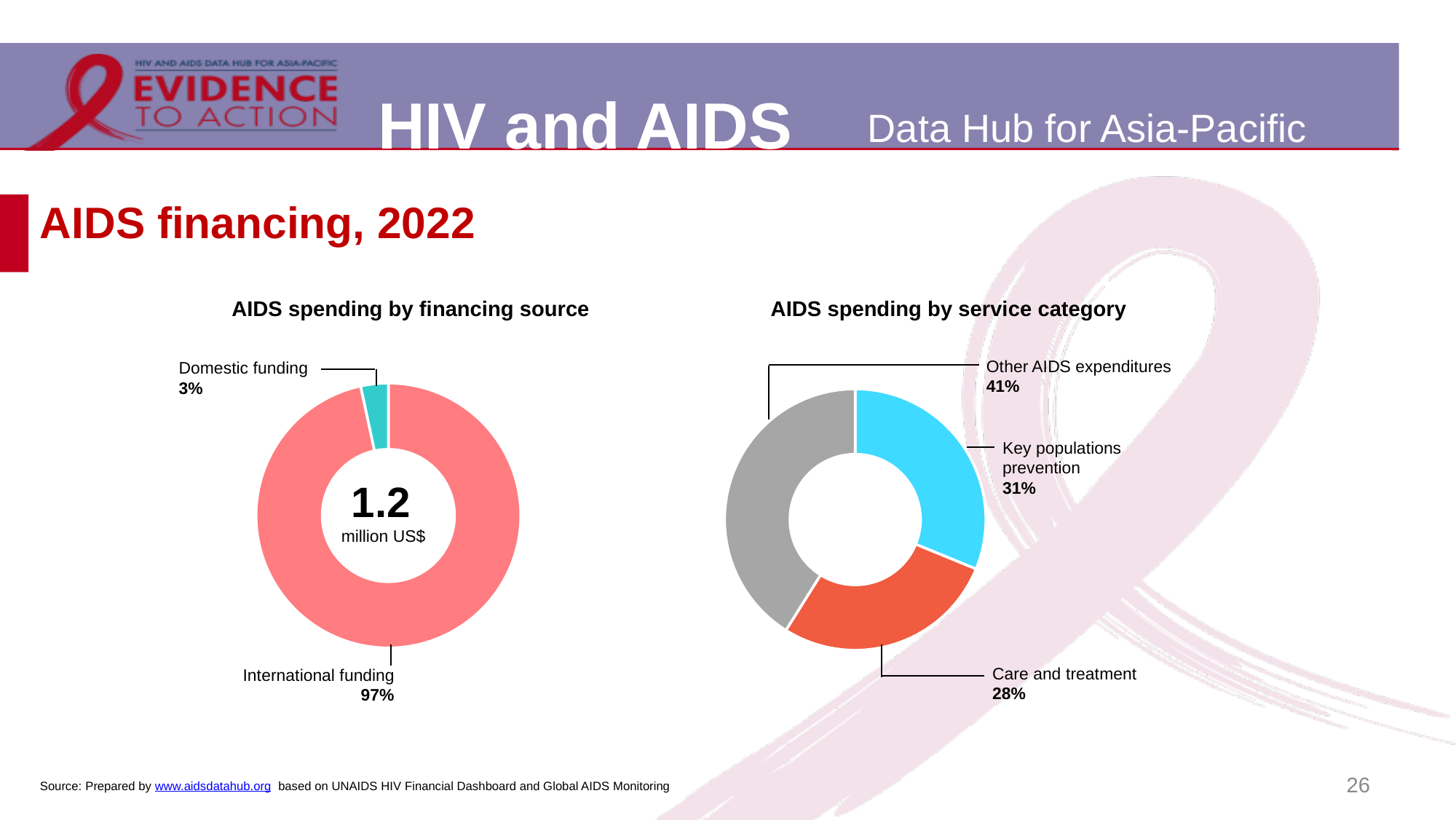
In the 'AIDS spending by financing source' chart, what share of spending comes from international funding? 97% In the 'AIDS spending by service category' chart, which service category has the largest share? Other AIDS expenditures In the 'AIDS spending by service category' chart, what share of spending goes to care and treatment? 28% In the 'AIDS spending by financing source' chart, what total amount is shown in the centre of the donut? 1.2 million US$ In the 'AIDS spending by service category' chart, how many service categories are shown? 3 In the 'AIDS spending by service category' chart, what share of spending goes to key populations prevention? 31% What kind of chart is 'AIDS spending by financing source'? Donut (pie) chart In the 'AIDS spending by financing source' chart, what share of spending comes from domestic funding? 3% In the 'AIDS spending by financing source' chart, which financing source has the larger share? International funding In the 'AIDS spending by service category' chart, which service category has the smallest share? Care and treatment In the 'AIDS spending by service category' chart, what is the difference in percentage points between other AIDS expenditures and care and treatment? 13 In the 'AIDS spending by financing source' chart, what is the difference in percentage points between international funding and domestic funding? 94